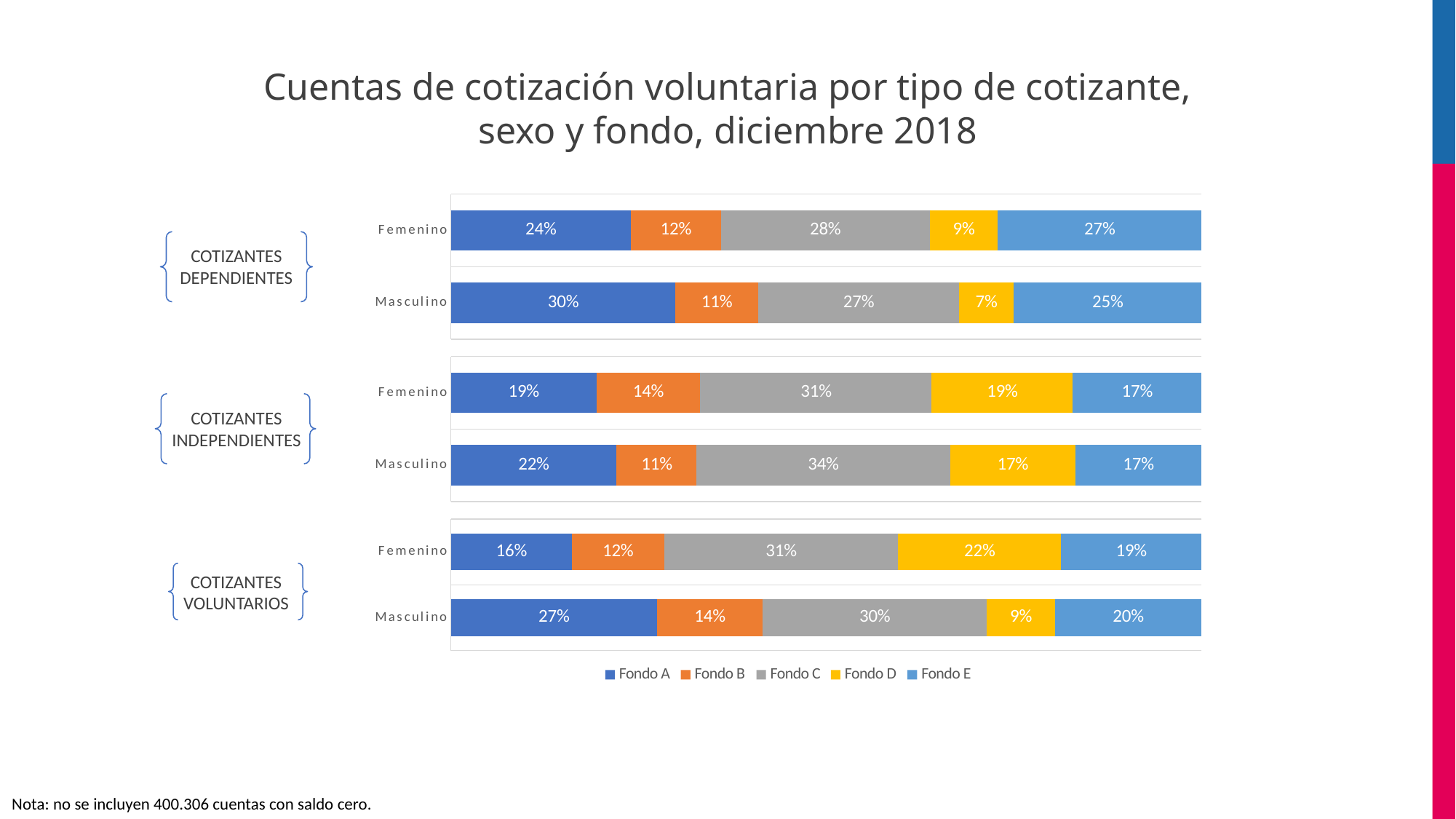
Which fund has the smallest share in the Masculino bar of Cotizantes Dependientes? Fondo D Which is larger: the Fondo E share for Femenino in Cotizantes Dependientes or the Fondo E share for Masculino in Cotizantes Voluntarios? Femenino in Cotizantes Dependientes What is the value for Fondo C in the Masculino bar of Cotizantes Independientes? 34% What is the value for Fondo A in the Masculino bar of Cotizantes Dependientes? 30% Which fund has the largest share in the Femenino bar of Cotizantes Independientes? Fondo C How many series does the legend list? 5 What kind of chart is shown on the slide? Stacked bar chart What is the value for Fondo B in the Masculino bar of Cotizantes Voluntarios? 14% What is the value for Fondo D in the Femenino bar of Cotizantes Voluntarios? 22% Within Cotizantes Dependientes, how much larger is the Fondo A share for Masculino than for Femenino? 6 percentage points How many bars are plotted in the chart? 6 What is the total of the Femenino bar of Cotizantes Dependientes? 100%